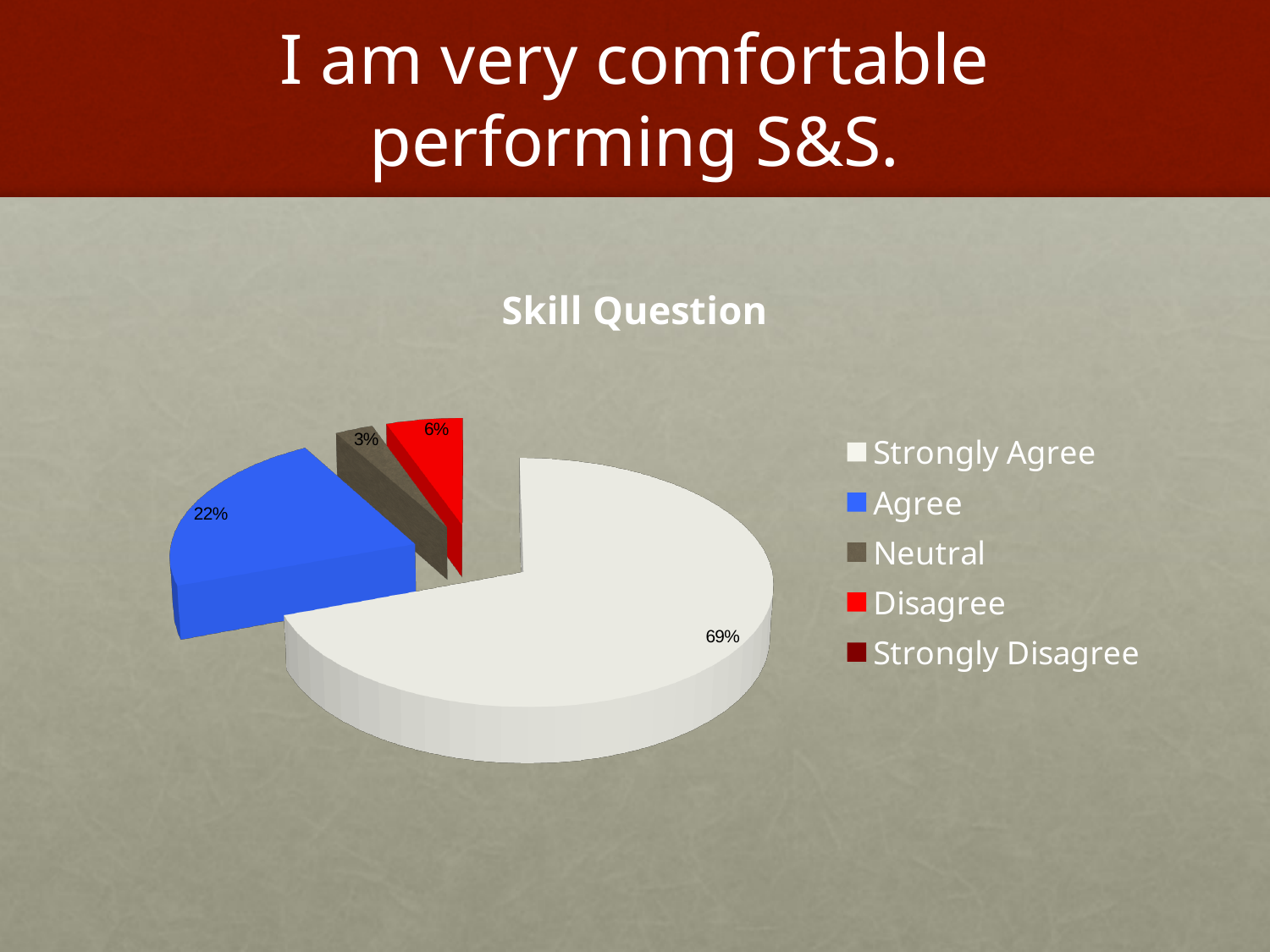
What colour is the Agree slice? blue What kind of chart is shown on the slide? pie chart How many entries does the legend list? 5 Which category has the largest share of the pie? Strongly Agree Which labelled slice has the smallest share of the pie? Neutral What is the title of the chart? Skill Question What percentage of the pie is Neutral? 3% What percentage of the pie is Disagree? 6% What is the difference in percentage points between Strongly Agree and Agree? 47 What percentage of the pie is Strongly Agree? 69% Which is larger, the Disagree slice or the Neutral slice? Disagree What percentage of the pie is Agree? 22%